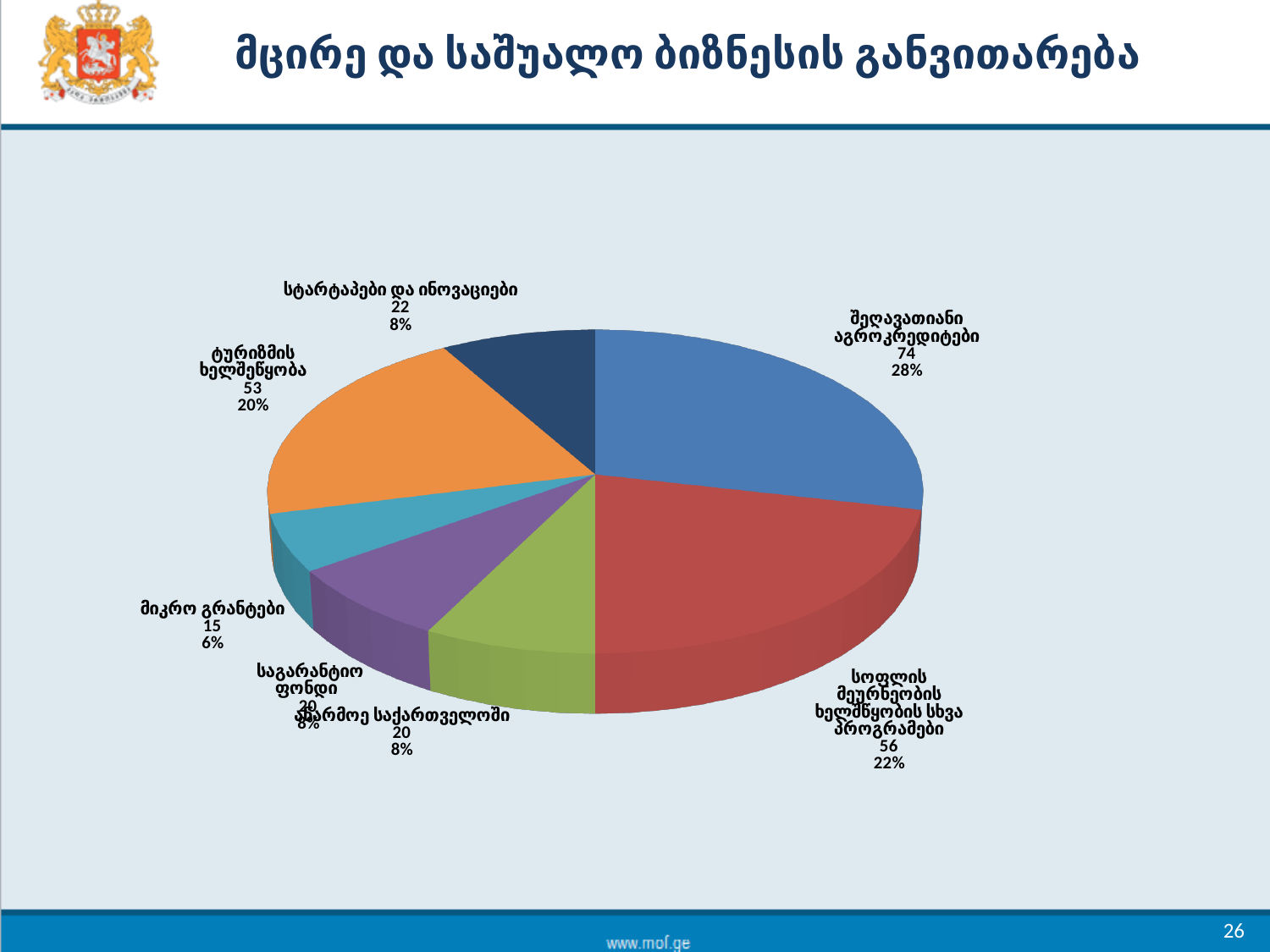
What is the title of the slide containing the pie chart? მცირე და საშუალო ბიზნესის განვითარება What is the value for მიკრო გრანტები? 15 How many slices does the pie chart have? 7 What percentage is shown for სტარტაპები და ინოვაციები? 8% What is the value for ტურიზმის ხელშეწყობა? 53 What share of the pie does შეღავათიანი აგროკრედიტები represent? 28% Which category has the smallest slice of the pie? მიკრო გრანტები What is the value for შეღავათიანი აგროკრედიტები? 74 What is the difference between the values for შეღავათიანი აგროკრედიტები and სოფლის მეურნეობის ხელშეწყობის სხვა პროგრამები? 18 Which category has the largest slice of the pie? შეღავათიანი აგროკრედიტები Which is larger, the value for ტურიზმის ხელშეწყობა or the value for სოფლის მეურნეობის ხელშეწყობის სხვა პროგრამები? სოფლის მეურნეობის ხელშეწყობის სხვა პროგრამები What kind of chart is shown on the slide? pie chart